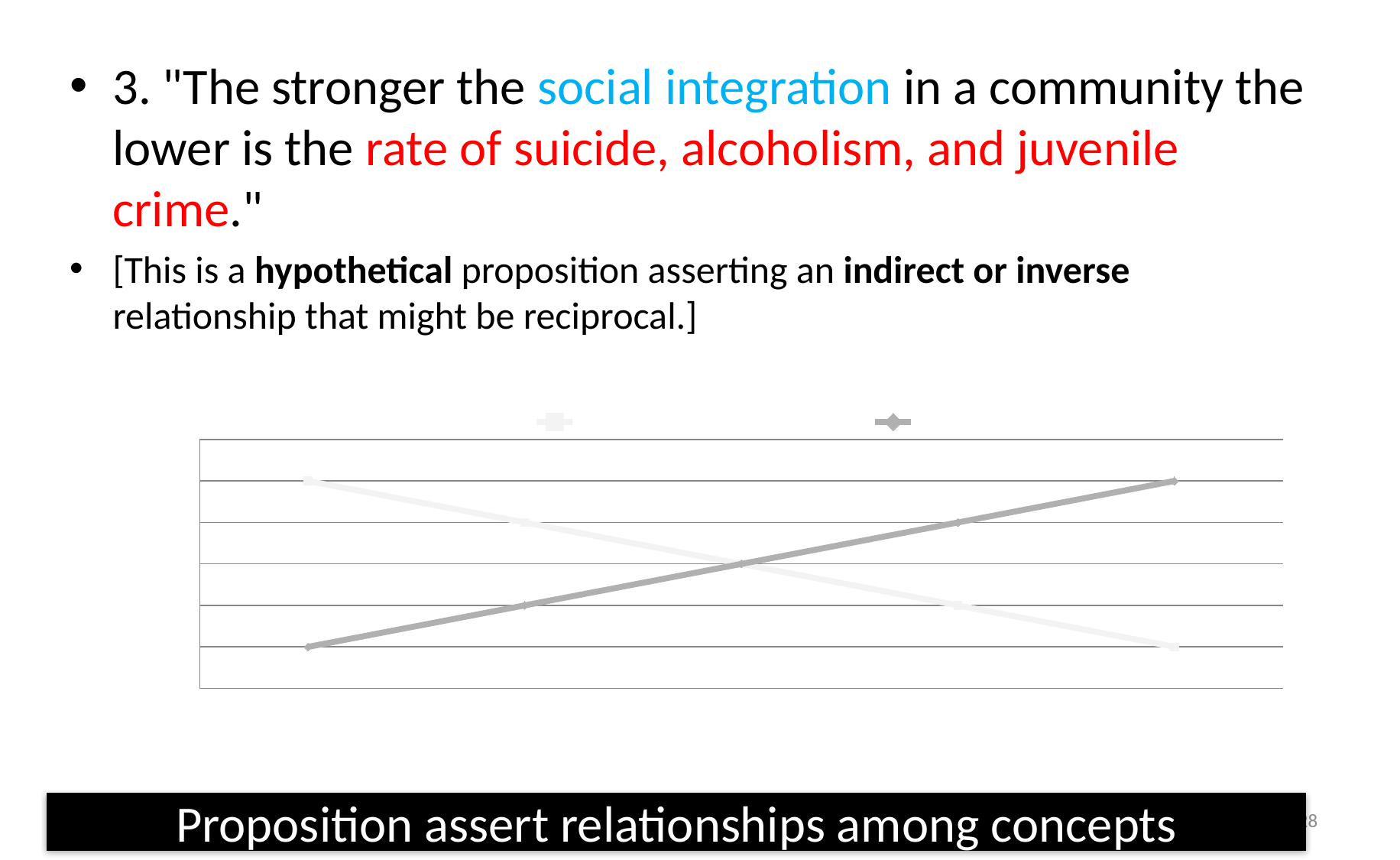
What kind of chart is shown on the slide? line chart How many horizontal gridlines are drawn inside the chart's plot area, including the top and bottom borders? 7 How many lines (series) are plotted in the chart? 2 Does the line that starts at the bottom left of the chart rise or fall along the x axis? rise Do the two lines in the chart move in the same direction or in opposite directions along the x axis? opposite directions Does the line that starts at the top left of the chart rise or fall along the x axis? fall How many data points does each line in the chart have? 5